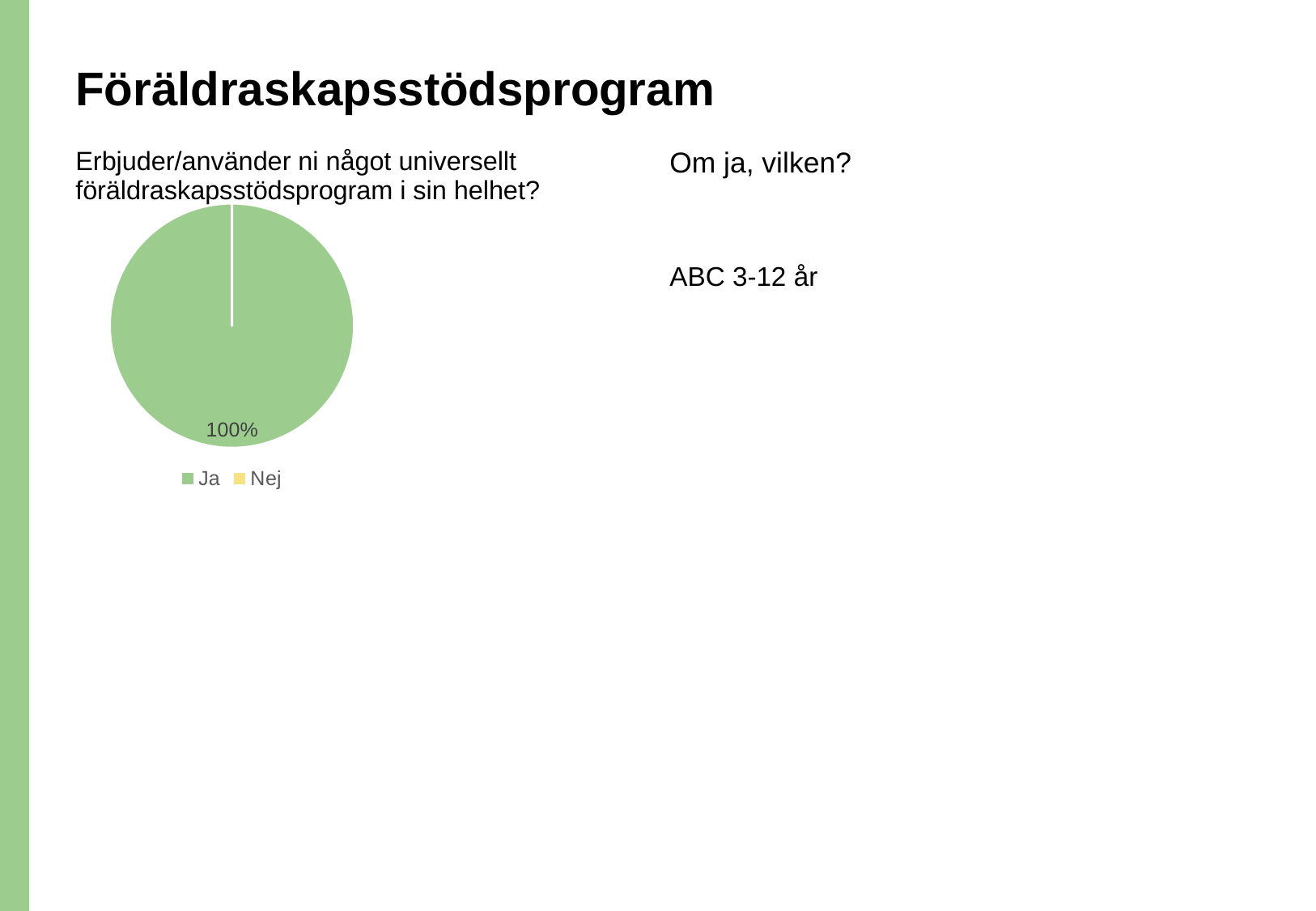
What colour is the "Ja" slice in the pie chart? green What kind of chart is shown on the slide? pie chart Which category has the largest share of the pie? Ja What share of the pie does the "Ja" slice represent? 100% How many entries does the legend list? 2 Which is larger, the share for "Ja" or the share for "Nej"? Ja Which category has the smallest share of the pie? Nej What are the two legend entries of the pie chart? Ja and Nej